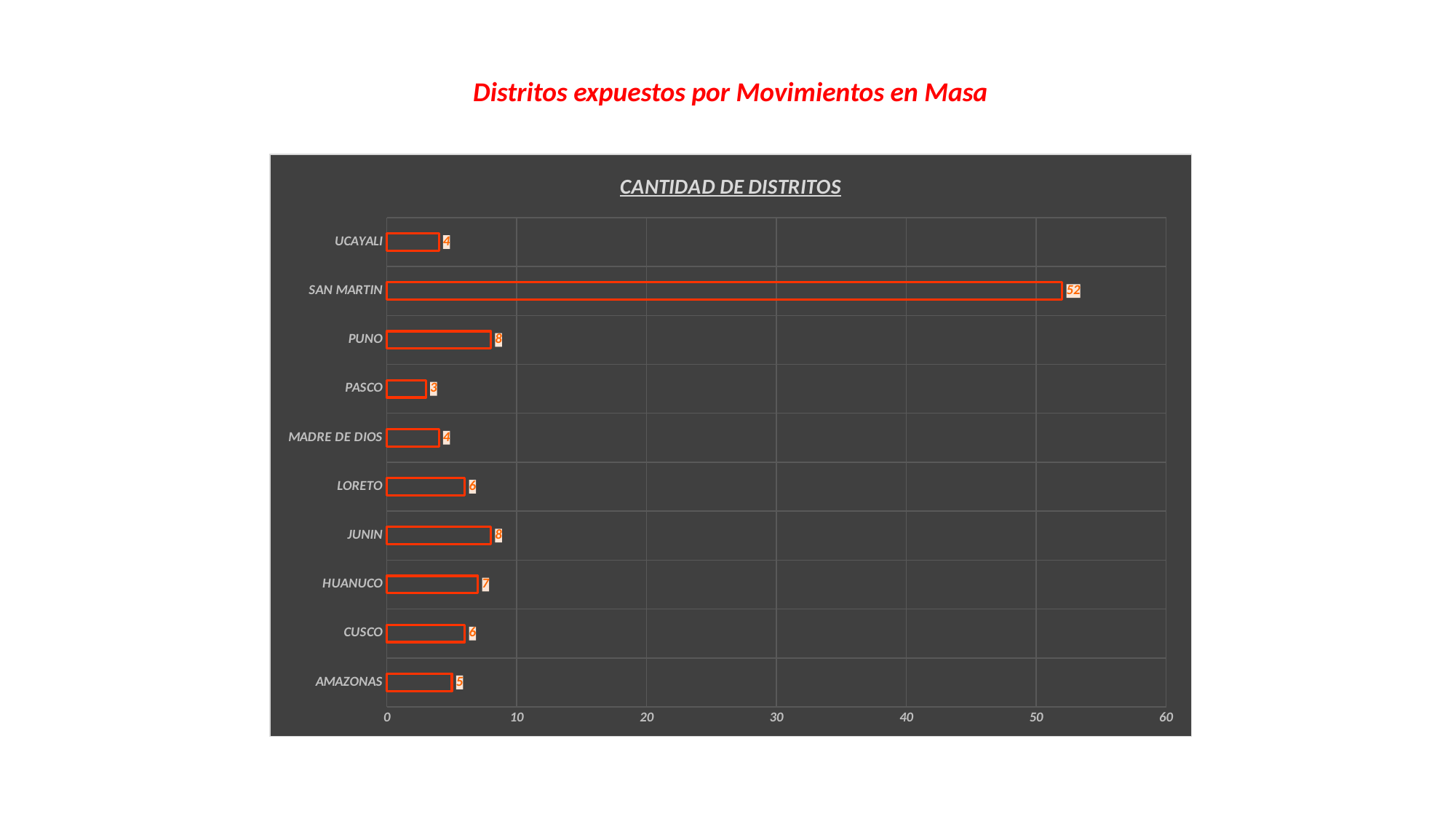
What is the title of the chart? CANTIDAD DE DISTRITOS What is the difference between the values for SAN MARTIN and PUNO? 44 Which category has the highest value? SAN MARTIN How many categories are shown on the chart? 10 Which category has the lowest value? PASCO Is the value for SAN MARTIN greater or less than 50? greater What is the value for AMAZONAS? 5 What is the value for PASCO? 3 Which is larger, the value for HUANUCO or the value for CUSCO? HUANUCO What is the value for PUNO? 8 What kind of chart is shown on the slide? bar chart What is the value for SAN MARTIN? 52